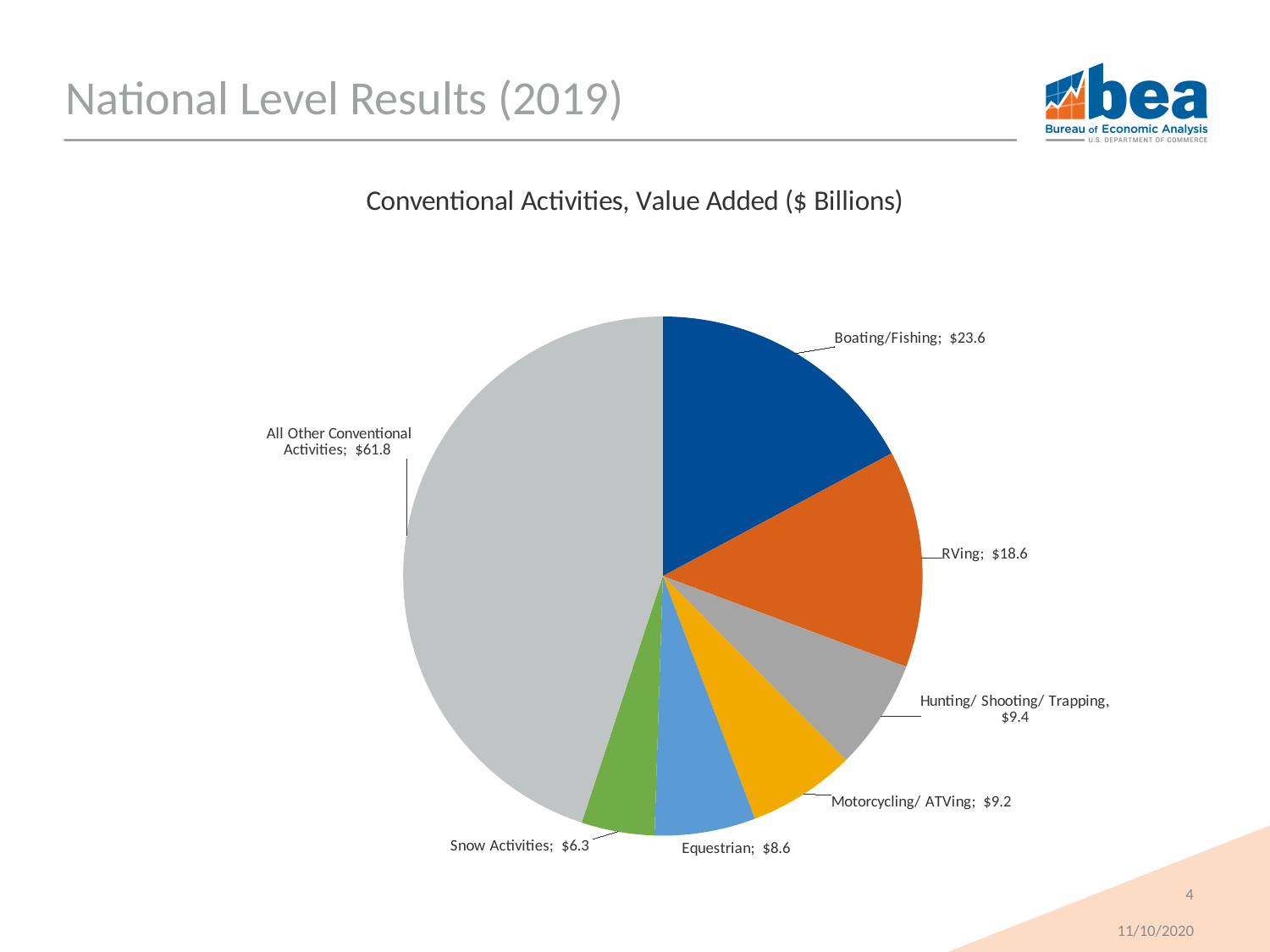
What is the value added for Snow Activities? $6.3 What is the title of the chart? Conventional Activities, Value Added ($ Billions) Which category has the largest slice of the pie? All Other Conventional Activities What is the difference between the values for Boating/Fishing and RVing? $5.0 Which has a larger value, Hunting/ Shooting/ Trapping or Motorcycling/ ATVing? Hunting/ Shooting/ Trapping Which category has the smallest slice of the pie? Snow Activities What is the value added for Equestrian? $8.6 What is the value added for RVing? $18.6 What kind of chart is shown on the slide? Pie chart How many slices does the pie chart have? 7 What is the difference between the values for Hunting/ Shooting/ Trapping and Equestrian? $0.8 What is the value added for Boating/Fishing? $23.6